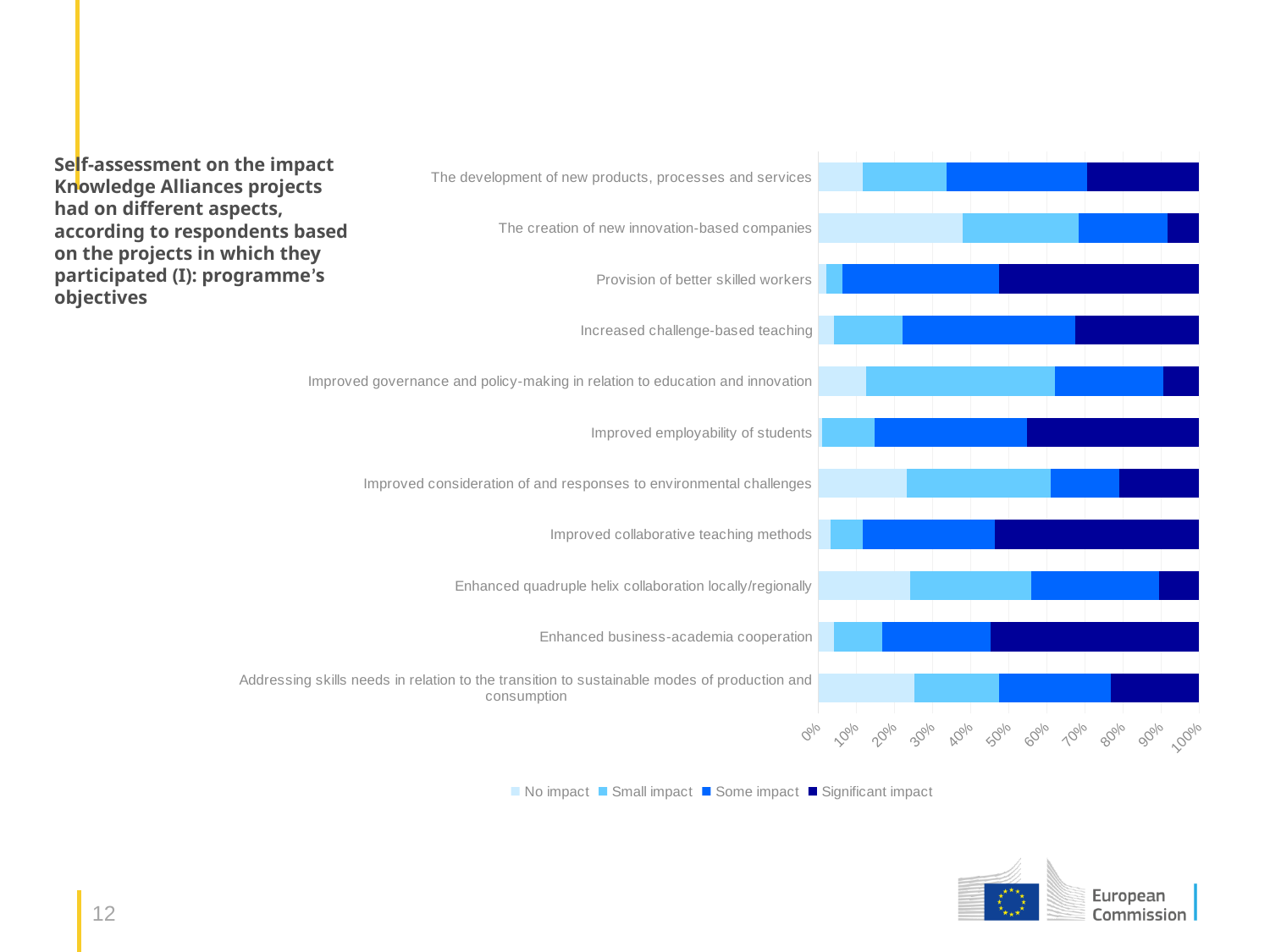
How many categories (aspects) are plotted on the chart? 11 How many series does the chart legend list? 4 Which has a larger 'Significant impact' share: 'Enhanced business-academia cooperation' or 'Enhanced quadruple helix collaboration locally/regionally'? Enhanced business-academia cooperation What kind of chart is shown on the slide? Stacked bar chart What are the four series named in the chart legend? No impact, Small impact, Some impact, Significant impact What is the highest value shown on the chart's percentage axis? 100% Which category has the largest 'No impact' share? The creation of new innovation-based companies Is the 'Significant impact' share for 'Improved employability of students' greater or less than 30%? greater Is the 'Significant impact' share for 'The creation of new innovation-based companies' greater or less than 20%? less Is the 'No impact' share for 'Provision of better skilled workers' greater or less than 10%? less Which has a larger 'No impact' share: 'Improved consideration of and responses to environmental challenges' or 'Improved collaborative teaching methods'? Improved consideration of and responses to environmental challenges